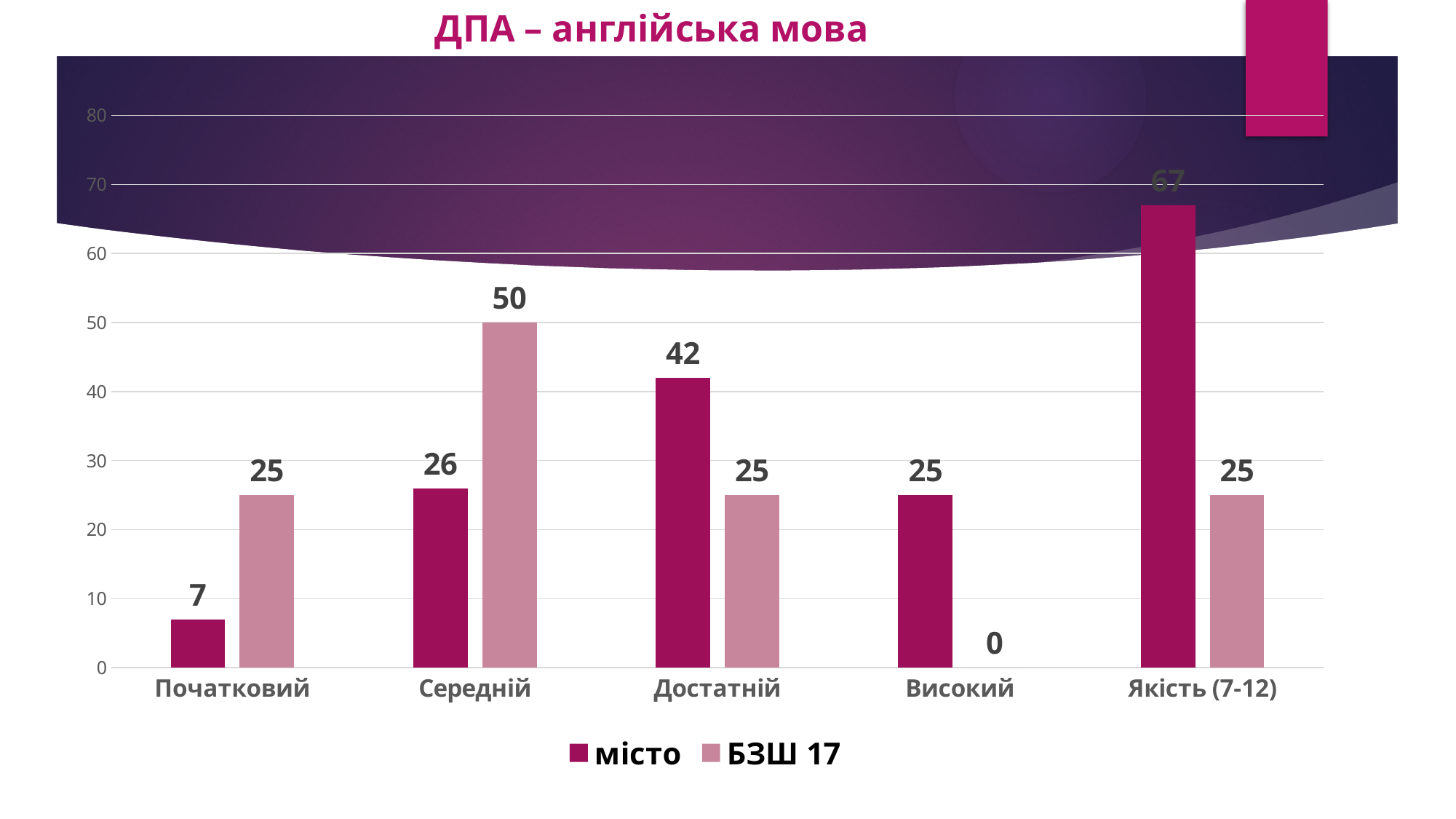
Is the value for місто in the Якість (7-12) category greater or less than 60? greater How many series does the legend list? 2 In the Середній category, which series has the larger value, місто or БЗШ 17? БЗШ 17 What is the value for місто in the Достатній category? 42 What is the value for БЗШ 17 in the Середній category? 50 What is the value for БЗШ 17 in the Високий category? 0 What is the value for місто in the Початковий category? 7 How many categories are shown on the x axis? 5 Which category has the lowest value for БЗШ 17? Високий Which category has the highest value for місто? Якість (7-12) What is the difference between місто and БЗШ 17 in the Якість (7-12) category? 42 What is the title of the chart? ДПА – англійська мова